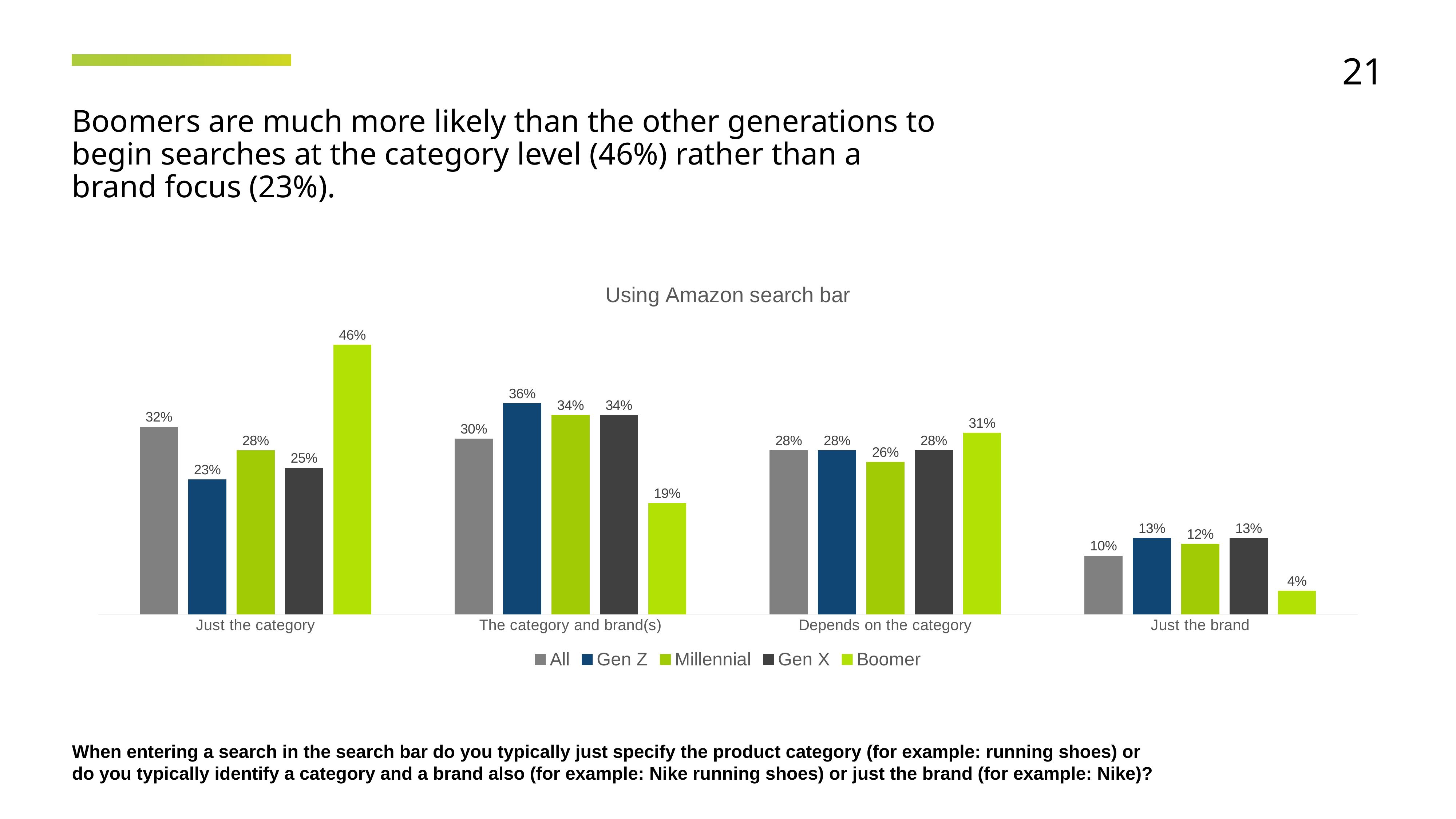
How many categories are shown on the x axis? 4 How many series does the legend list? 5 Which series has the highest value in the "Just the category" group? Boomer Which is larger in the "Just the brand" group: the value for All or the value for Gen X? Gen X Which series has the lowest value in the "The category and brand(s)" group? Boomer What kind of chart is shown on the slide? Bar chart What is the value for Gen Z in the "The category and brand(s)" group? 36% What is the value for Boomer in the "Just the brand" group? 4% What is the value for Millennial in the "Depends on the category" group? 26% What is the difference between the Boomer and Gen Z values in the "Just the category" group? 23% What is the title of the chart? Using Amazon search bar What is the value for Boomer in the "Just the category" group? 46%